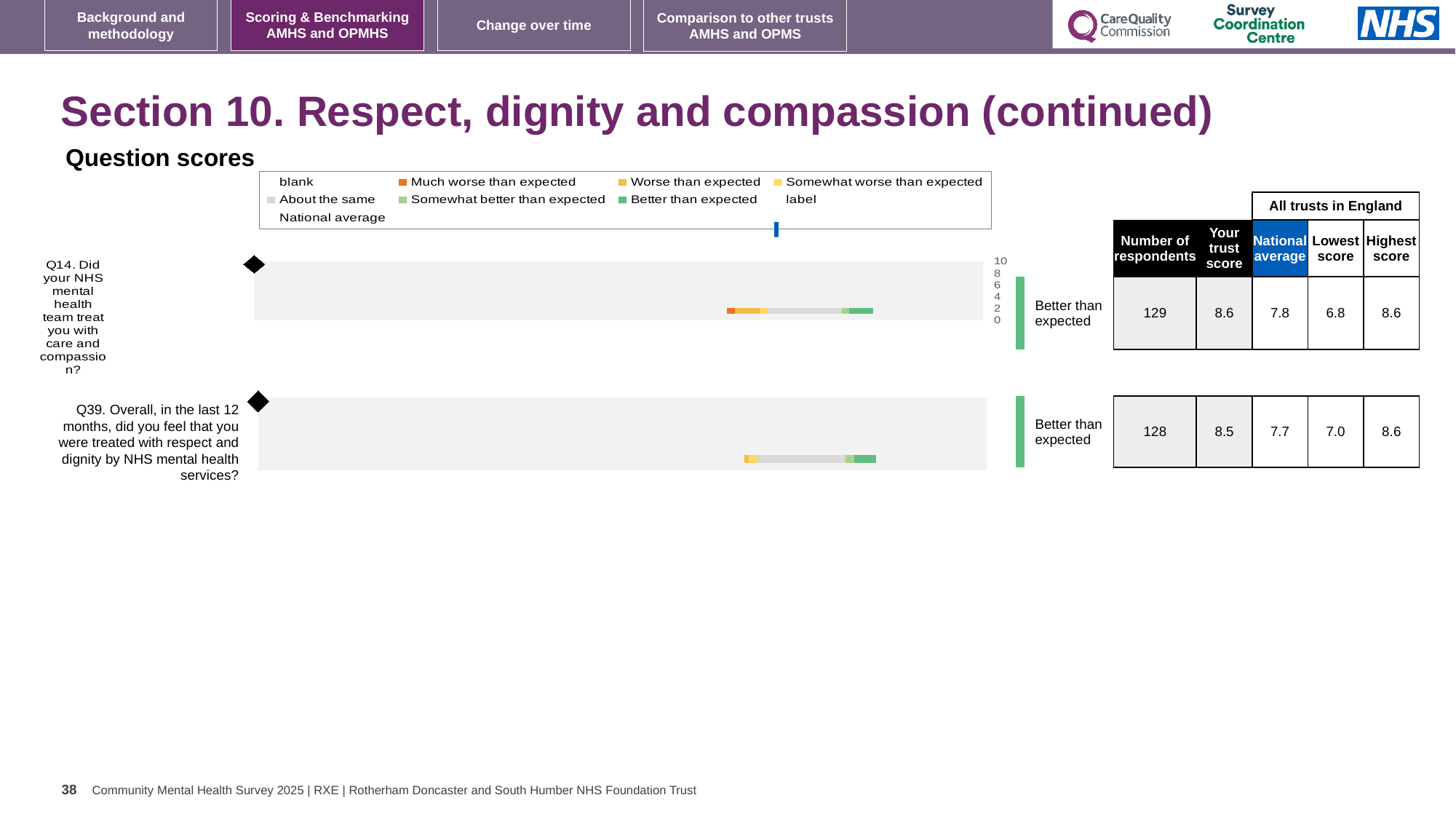
What kind of chart is used to show the question scores for Q14 and Q39? bar chart What is the lowest score among all trusts in England for Q39? 7.0 How many questions are charted on the slide? 2 What benchmark label is shown to the right of both charts? Better than expected What is the difference between the highest and lowest scores for Q39? 1.6 What is the highest score among all trusts in England for Q14? 8.6 By how much does the Q14 trust score exceed the national average for Q14? 0.8 How many respondents answered Q39? 128 Which question has the higher trust score, Q14 or Q39? Q14 What is the trust score for Q14 (care and compassion)? 8.6 What is the national average for Q14? 7.8 What is the trust score for Q39 (respect and dignity)? 8.5